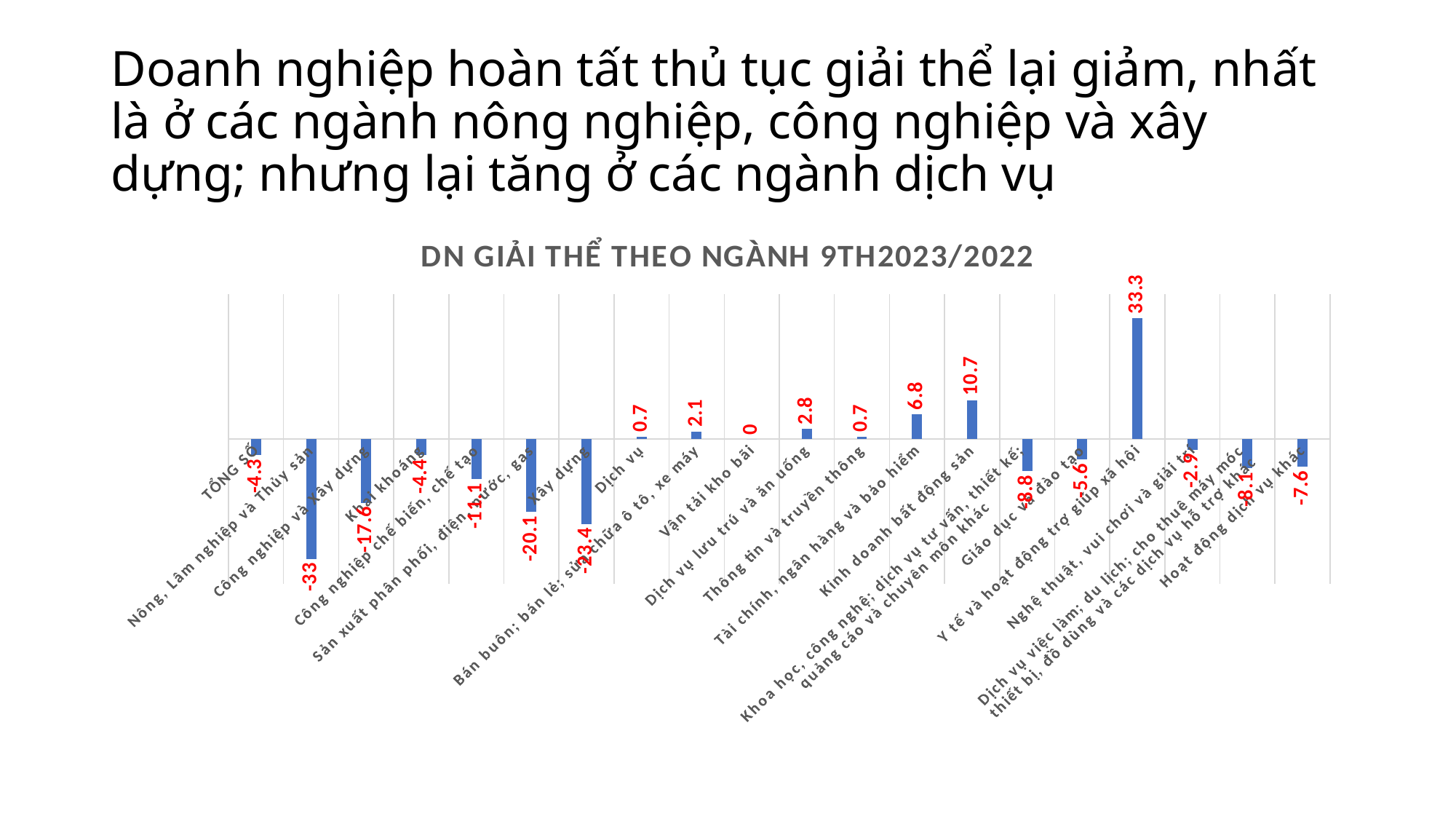
What is the title of the chart? DN GIẢI THỂ THEO NGÀNH 9TH2023/2022 What is the value for Y tế và hoạt động trợ giúp xã hội? 33.3 What is the difference between the values for Kinh doanh bất động sản and Tài chính, ngân hàng và bảo hiểm? 3.9 What is the value for Nông, Lâm nghiệp và Thủy sản? -33 What is the value for TỔNG SỐ? -4.3 Which category has the highest value? Y tế và hoạt động trợ giúp xã hội What is the value for Kinh doanh bất động sản? 10.7 Which category has the lowest value? Nông, Lâm nghiệp và Thủy sản What kind of chart is shown on the slide? Bar chart What is the value for Xây dựng? -23.4 Which is larger, the value for Xây dựng or the value for Sản xuất phân phối, điện, nước, gas? Sản xuất phân phối, điện, nước, gas How many categories are shown in the chart? 20